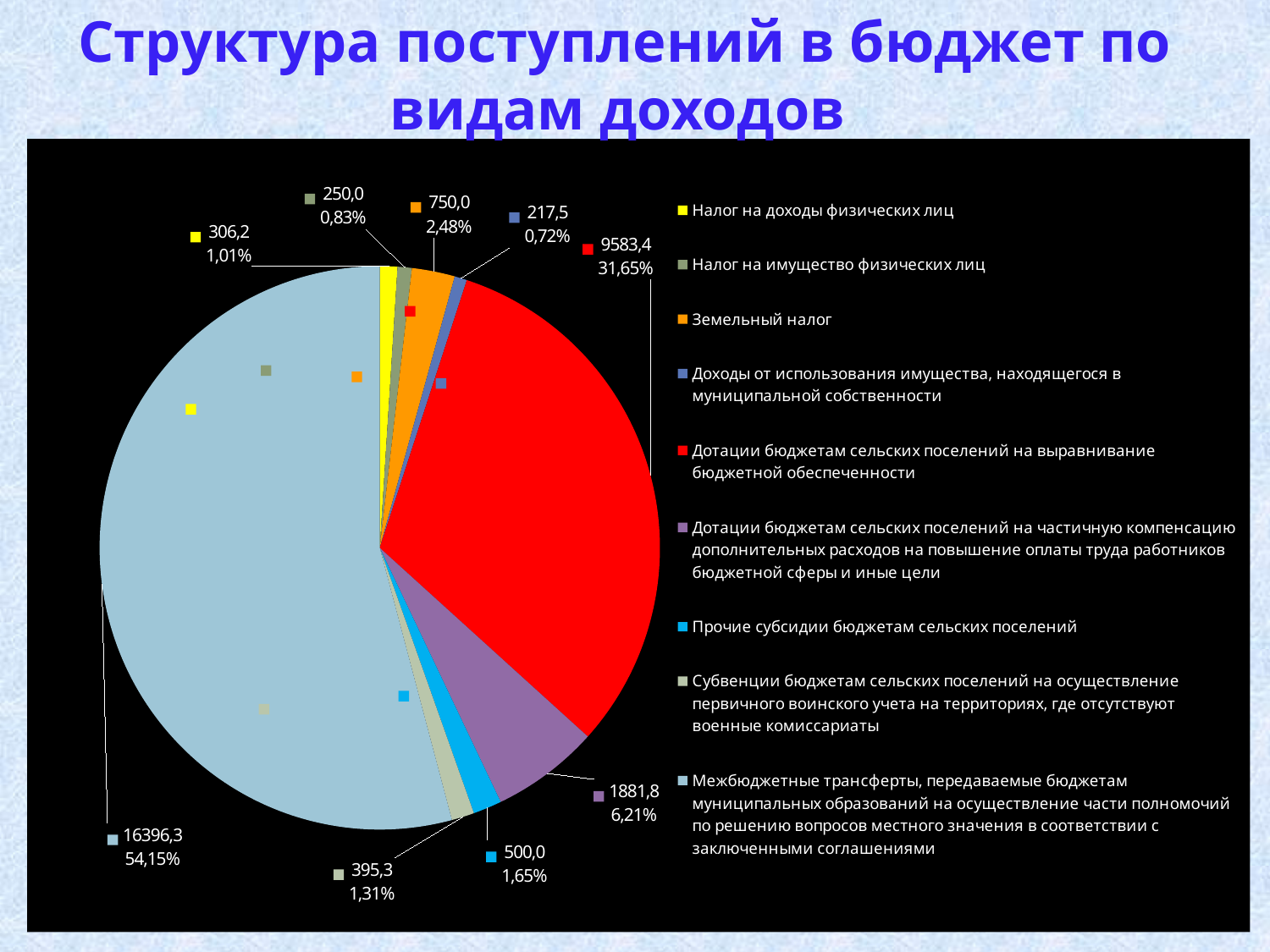
What percentage share is shown for "Дотации бюджетам сельских поселений на выравнивание бюджетной обеспеченности"? 31,65% Which is larger: the value for "Налог на доходы физических лиц" or the value for "Субвенции бюджетам сельских поселений..."? Субвенции бюджетам сельских поселений на осуществление первичного воинского учета на территориях, где отсутствуют военные комиссариаты How many entries does the legend list? 9 Which category has the smallest slice of the pie? Доходы от использования имущества, находящегося в муниципальной собственности What is the title of the chart on the slide? Структура поступлений в бюджет по видам доходов What percentage share is shown for "Налог на имущество физических лиц"? 0,83% What is the value shown for "Прочие субсидии бюджетам сельских поселений"? 500,0 What is the value shown for "Земельный налог"? 750,0 What is the difference between the values for "Дотации бюджетам сельских поселений на частичную компенсацию..." (1881,8) and "Земельный налог" (750,0)? 1131,8 What type of chart is shown on the slide? pie chart Which category has the largest slice of the pie? Межбюджетные трансферты, передаваемые бюджетам муниципальных образований на осуществление части полномочий по решению вопросов местного значения в соответствии с заключенными соглашениями How many slices does the pie chart have? 9